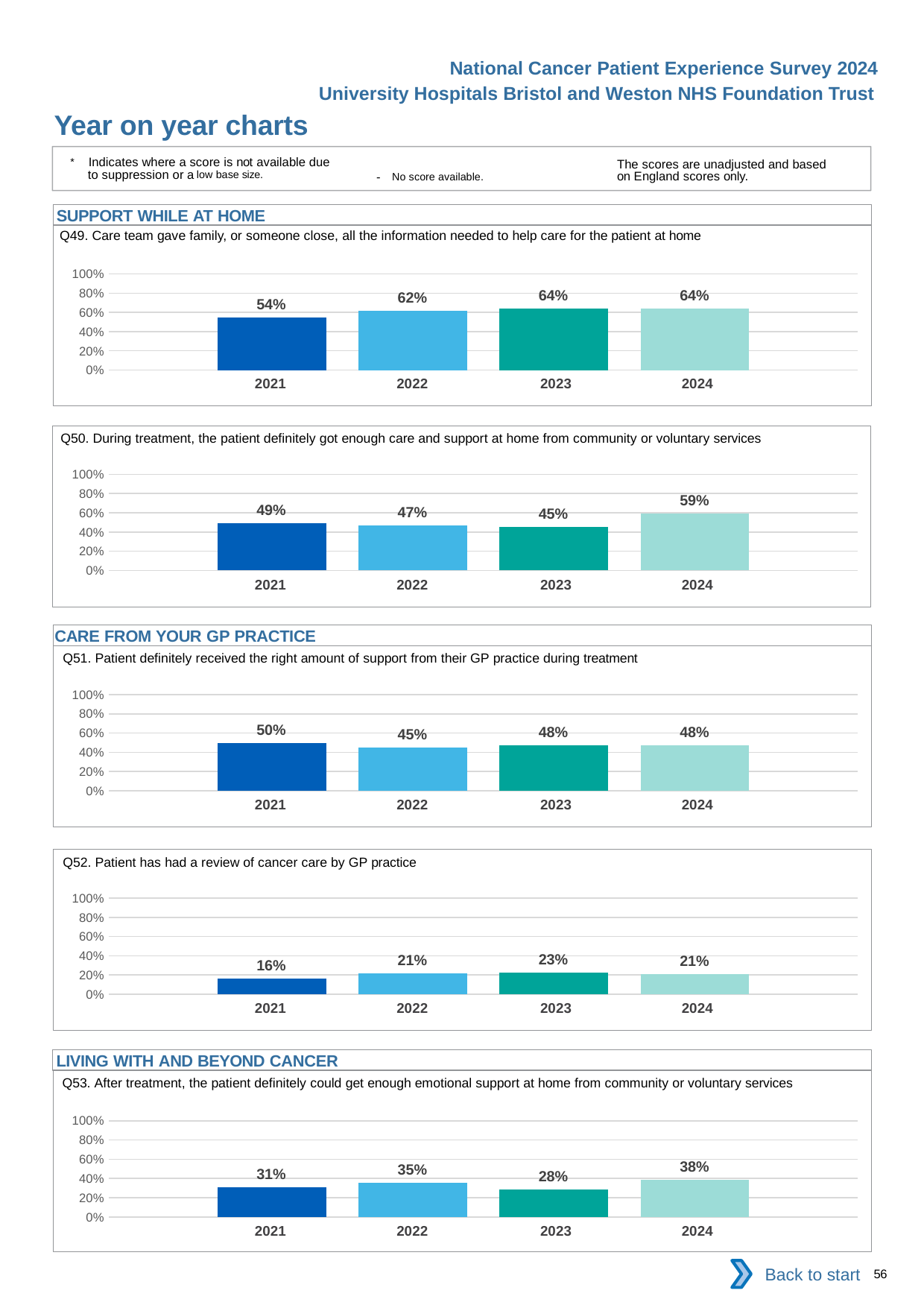
In the Q52 chart, which is larger, the value for 2021 or the value for 2023? 2023 In the Q49 chart, do the values rise or fall from 2021 to 2023? Rise In the Q53 chart, what is the difference between the 2024 value and the 2023 value? 10% In the Q52 chart, what is the value for 2021? 16% In the Q52 chart, how many years are plotted? 4 Which section heading appears above the Q51 chart? CARE FROM YOUR GP PRACTICE What kind of chart is the Q49 chart? Bar chart In the Q53 chart, what is the value for 2024? 38% In the Q49 chart, what is the value for 2021? 54% In the Q51 chart, what is the difference between the 2021 value and the 2022 value? 5% In the Q50 chart, which year has the lowest value? 2023 In the Q50 chart, which year has the highest value? 2024